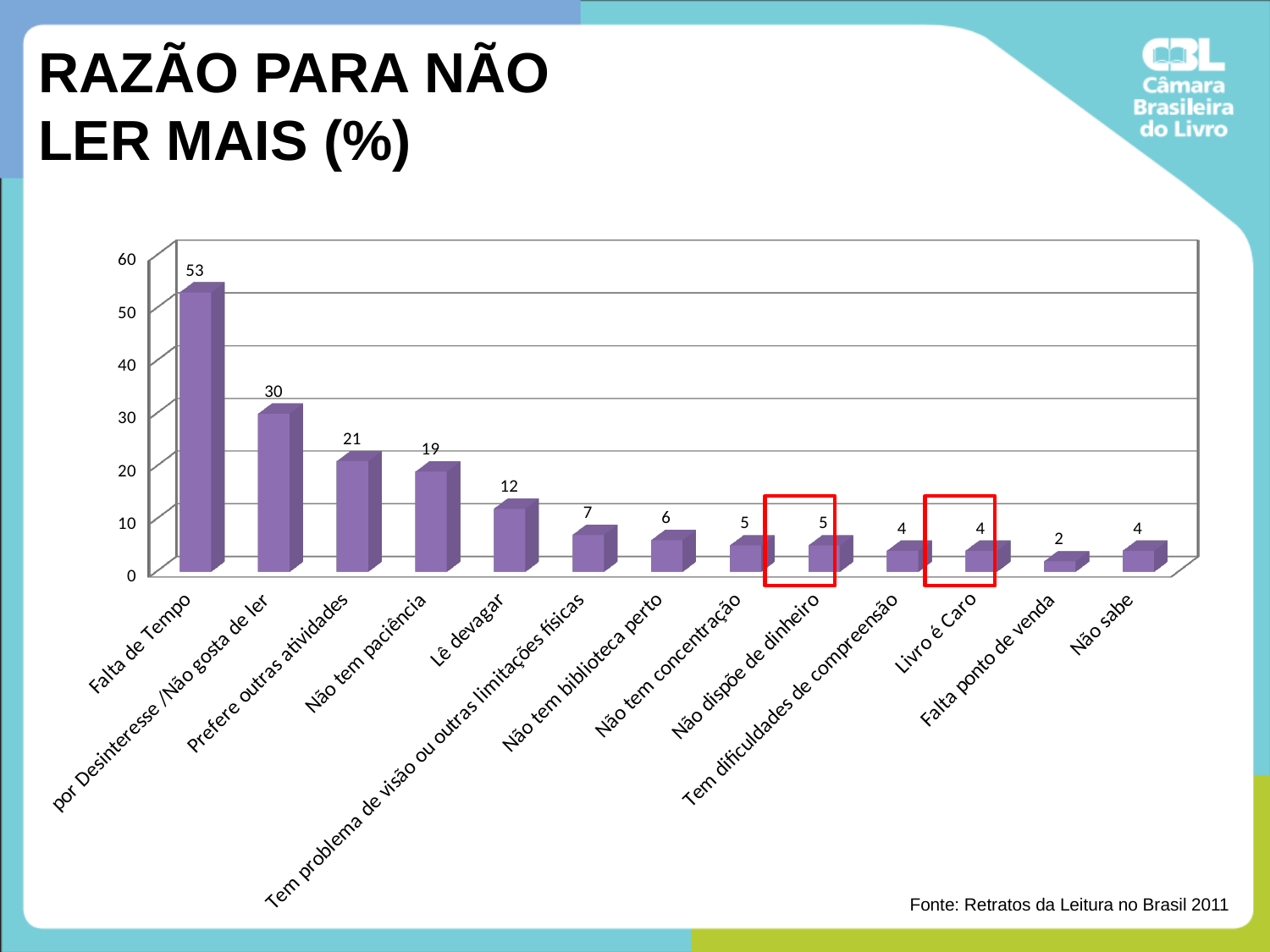
Which category has the highest value? Falta de Tempo What is the value for "Lê devagar"? 12 What is the difference between the values for "Falta de Tempo" and "por Desinteresse /Não gosta de ler"? 23 How many categories are shown in the chart? 13 Which category has the lowest value? Falta ponto de venda Which is larger, the value for "Prefere outras atividades" or the value for "Não tem paciência"? Prefere outras atividades What is the value for "Falta de Tempo"? 53 Do the values generally rise or fall from left to right along the x axis? Fall What is the title of the chart on the slide? RAZÃO PARA NÃO LER MAIS (%) What is the value for "Livro é Caro"? 4 What kind of chart is shown on the slide? Bar chart What is the value for "Não dispõe de dinheiro"? 5